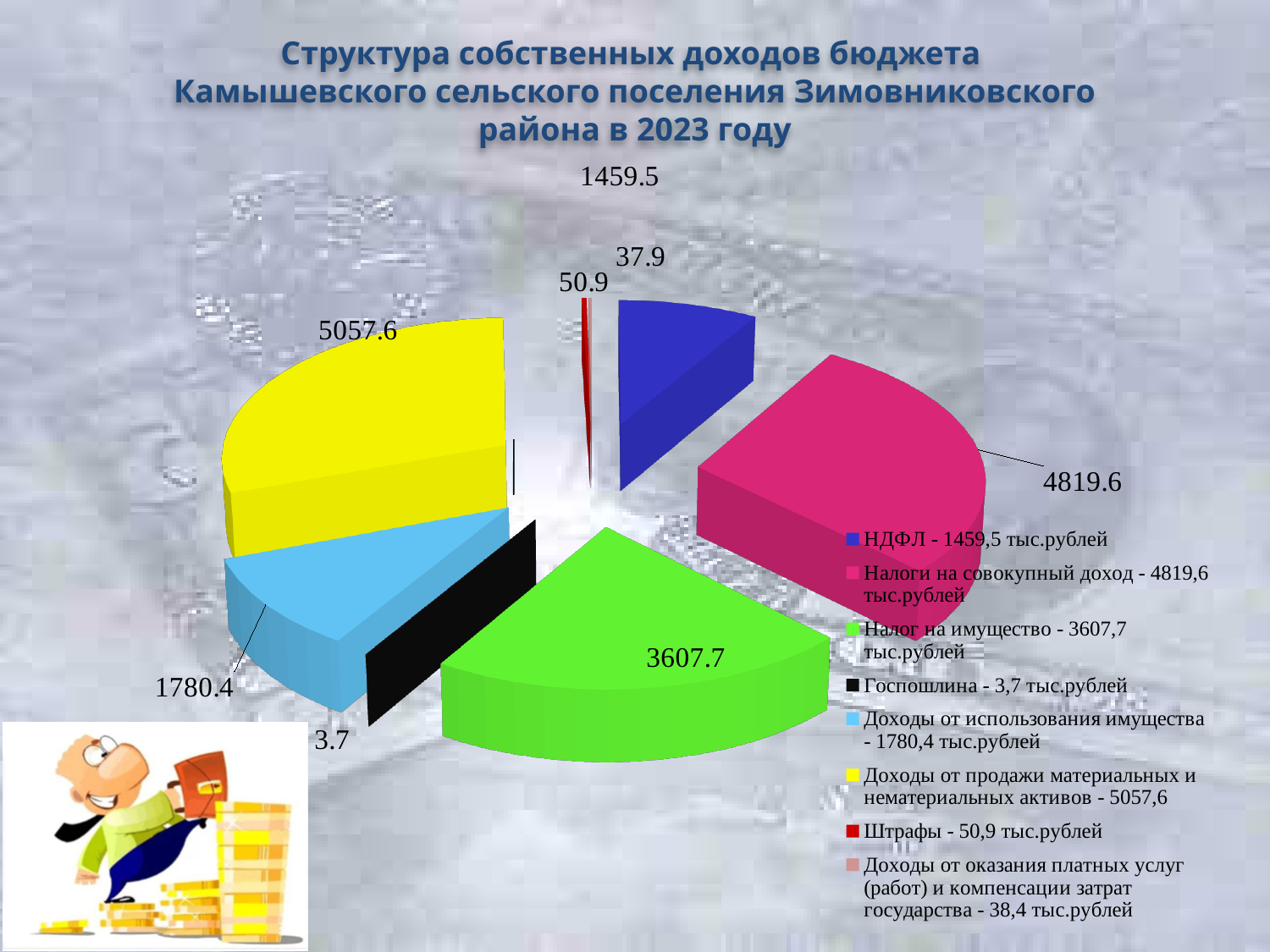
What value is shown for НДФЛ on the pie chart? 1459.5 What colour is the slice for Налоги на совокупный доход in the pie chart? pink Which category has the largest slice of the pie chart? Доходы от продажи материальных и нематериальных активов What value is shown for Штрафы on the pie chart? 50.9 What kind of chart is shown on the slide? pie chart How many entries does the legend of the pie chart list? 8 What is the difference between the values for Налог на имущество and Доходы от использования имущества? 1827.3 What value is shown for Доходы от использования имущества on the pie chart? 1780.4 Which category has the smallest slice of the pie chart? Госпошлина What is the difference between the values for Доходы от продажи материальных и нематериальных активов and Налоги на совокупный доход? 238.0 What value is shown for Налог на имущество on the pie chart? 3607.7 Which is larger: the value for Налоги на совокупный доход or the value for Налог на имущество? Налоги на совокупный доход